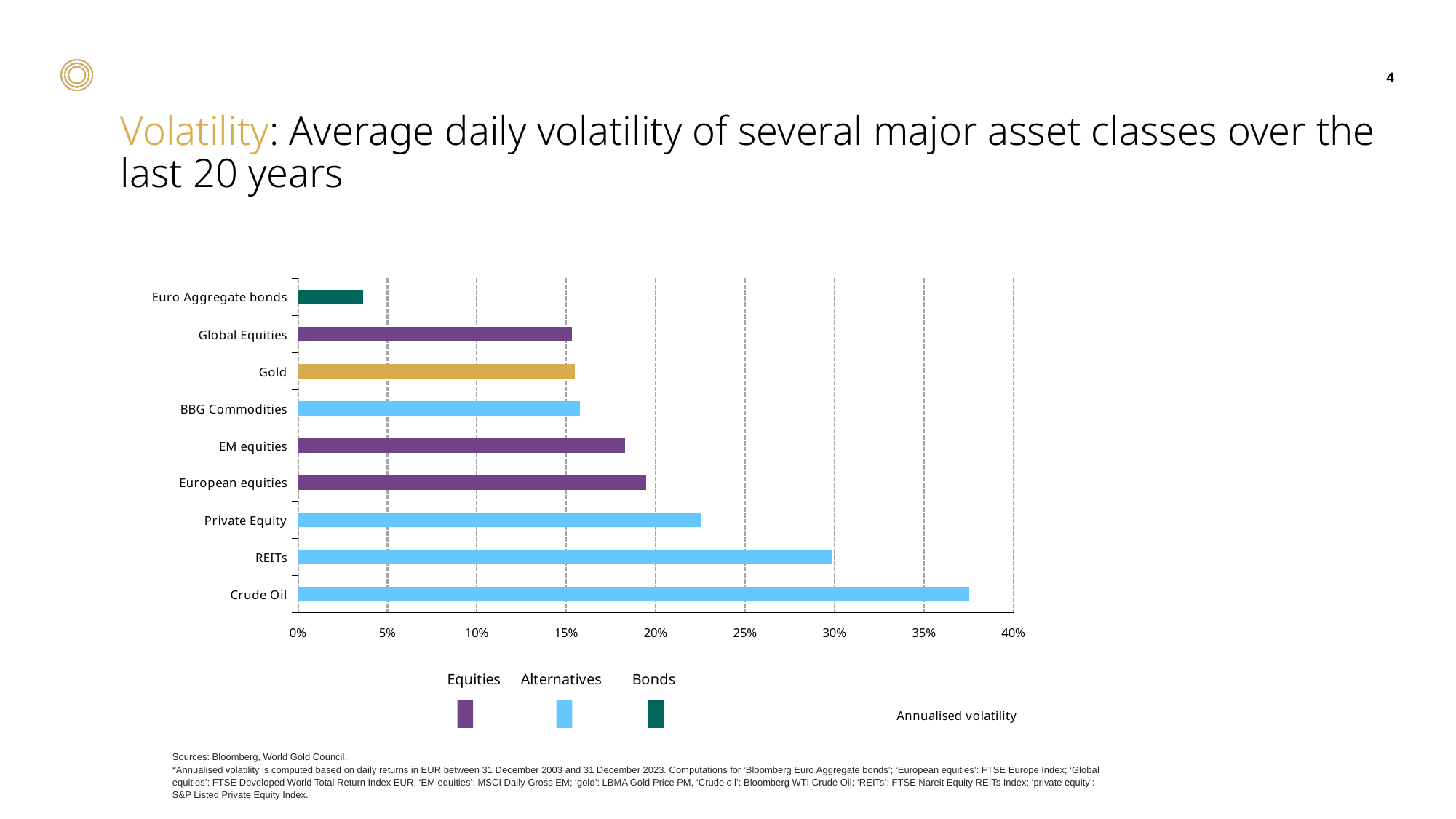
Which asset class has the highest annualised volatility? Crude Oil How many asset classes are plotted in the chart? 9 How many entries does the legend list? 3 What kind of chart is shown on the slide? bar chart Which has the higher annualised volatility, EM equities or Gold? EM equities Is the value for REITs greater or less than 25%? greater Which legend category is shown in dark green? Bonds Is the value for Euro Aggregate bonds greater or less than 5%? less Is the value for Private Equity greater or less than 20%? greater Which asset class has the lowest annualised volatility? Euro Aggregate bonds Which has the higher annualised volatility, Crude Oil or REITs? Crude Oil